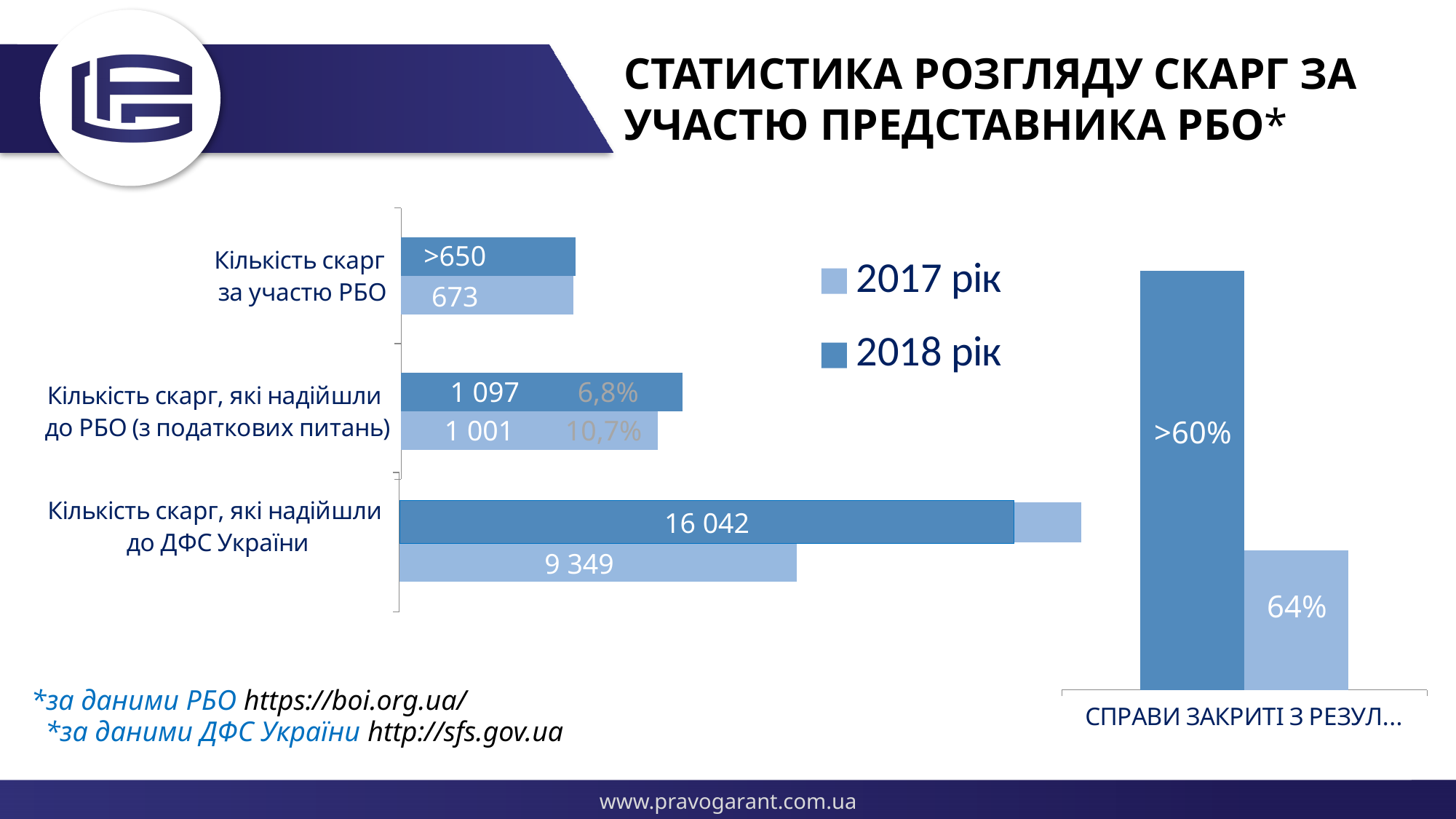
In the left bar chart, what is the difference between the 2018 and 2017 values for "Кількість скарг, які надійшли до ДФС України"? 6 693 In the left bar chart, what is the 2018 value for "Кількість скарг, які надійшли до ДФС України"? 16 042 In the left bar chart, which category has the highest 2018 value? Кількість скарг, які надійшли до ДФС України In the left bar chart, what is the 2017 value for "Кількість скарг за участю РБО"? 673 In the left bar chart, what is the 2017 value for "Кількість скарг, які надійшли до РБО (з податкових питань)"? 1 001 In the left bar chart, what is the 2017 value for "Кількість скарг, які надійшли до ДФС України"? 9 349 How many categories does the left bar chart show? 3 In the right chart titled "СПРАВИ ЗАКРИТІ З РЕЗУЛ...", what is the value for 2017? 64% How many series does the legend of the left chart list? 2 In the left bar chart, what is the difference between the 2018 and 2017 values for "Кількість скарг, які надійшли до РБО (з податкових питань)"? 96 In the left bar chart, what is the 2018 value for "Кількість скарг, які надійшли до РБО (з податкових питань)"? 1 097 What kind of chart is the chart on the left of the slide? bar chart